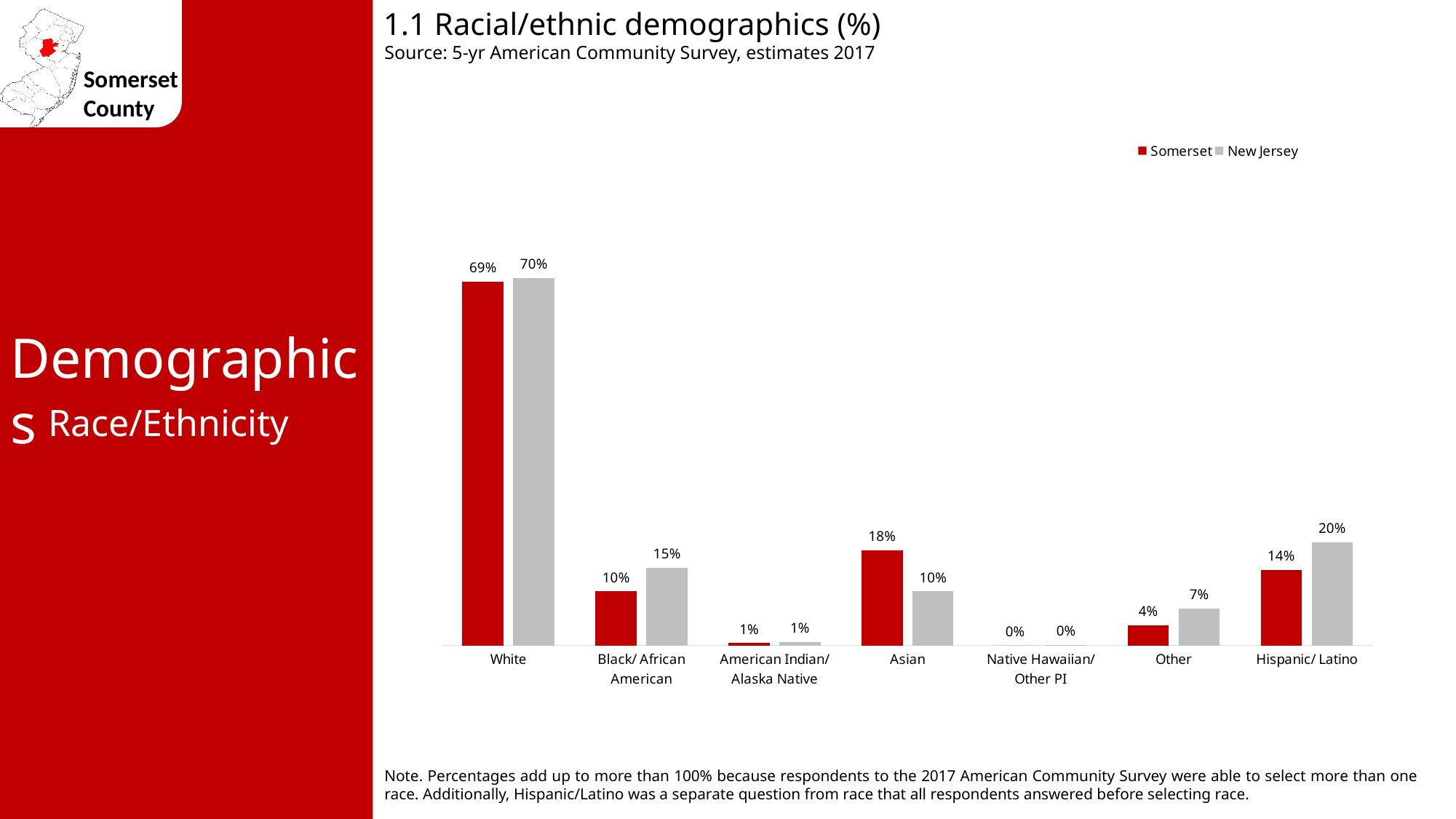
What is the Somerset value for Asian? 18% What is the New Jersey value for Other? 7% Which category has the lowest New Jersey value? Native Hawaiian/ Other PI Which is larger for Asian, the Somerset value or the New Jersey value? Somerset What is the difference between the New Jersey and Somerset values for Black/ African American? 5% How many series does the legend list? 2 What is the Somerset value for White? 69% Which colour represents New Jersey in the chart? Grey What is the New Jersey value for Hispanic/ Latino? 20% What kind of chart is shown? Bar chart How many categories are shown on the x axis? 7 Which category has the highest Somerset value? White